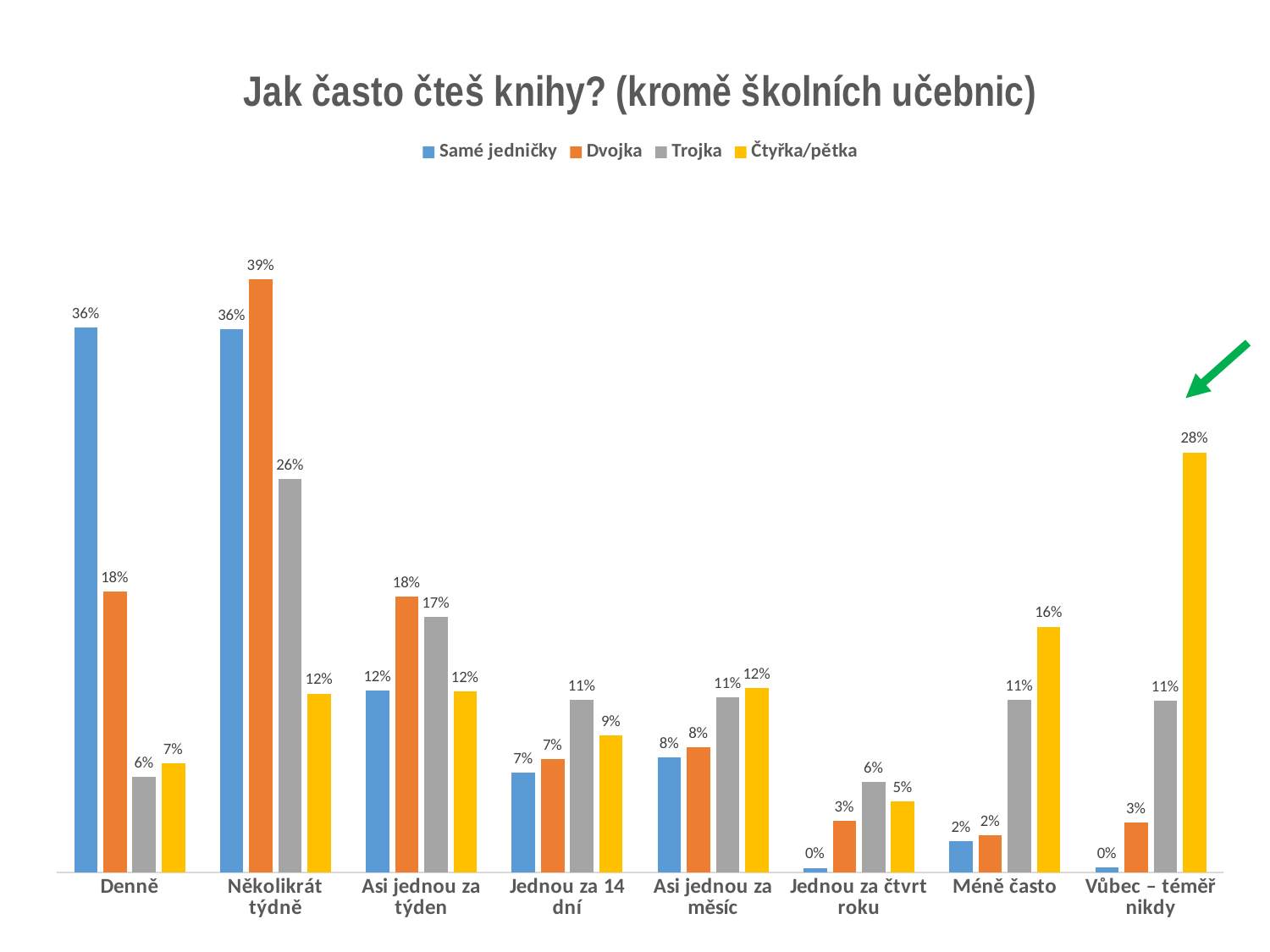
Which category has the lowest value for the Čtyřka/pětka series? Jednou za čtvrt roku What is the title of the chart? Jak často čteš knihy? (kromě školních učebnic) How many categories are shown on the x axis? 8 What is the value for Samé jedničky in the Denně category? 36% What is the value for Trojka in the Několikrát týdně category? 26% Which series is shown in yellow? Čtyřka/pětka What is the value for Čtyřka/pětka in the Vůbec – téměř nikdy category? 28% What is the difference between the Dvojka and Samé jedničky values in the Denně category? 18% In the Méně často category, which is larger: Trojka or Čtyřka/pětka? Čtyřka/pětka Which category has the highest value for the Dvojka series? Několikrát týdně How many series does the legend list? 4 What kind of chart is shown on the slide? Bar chart